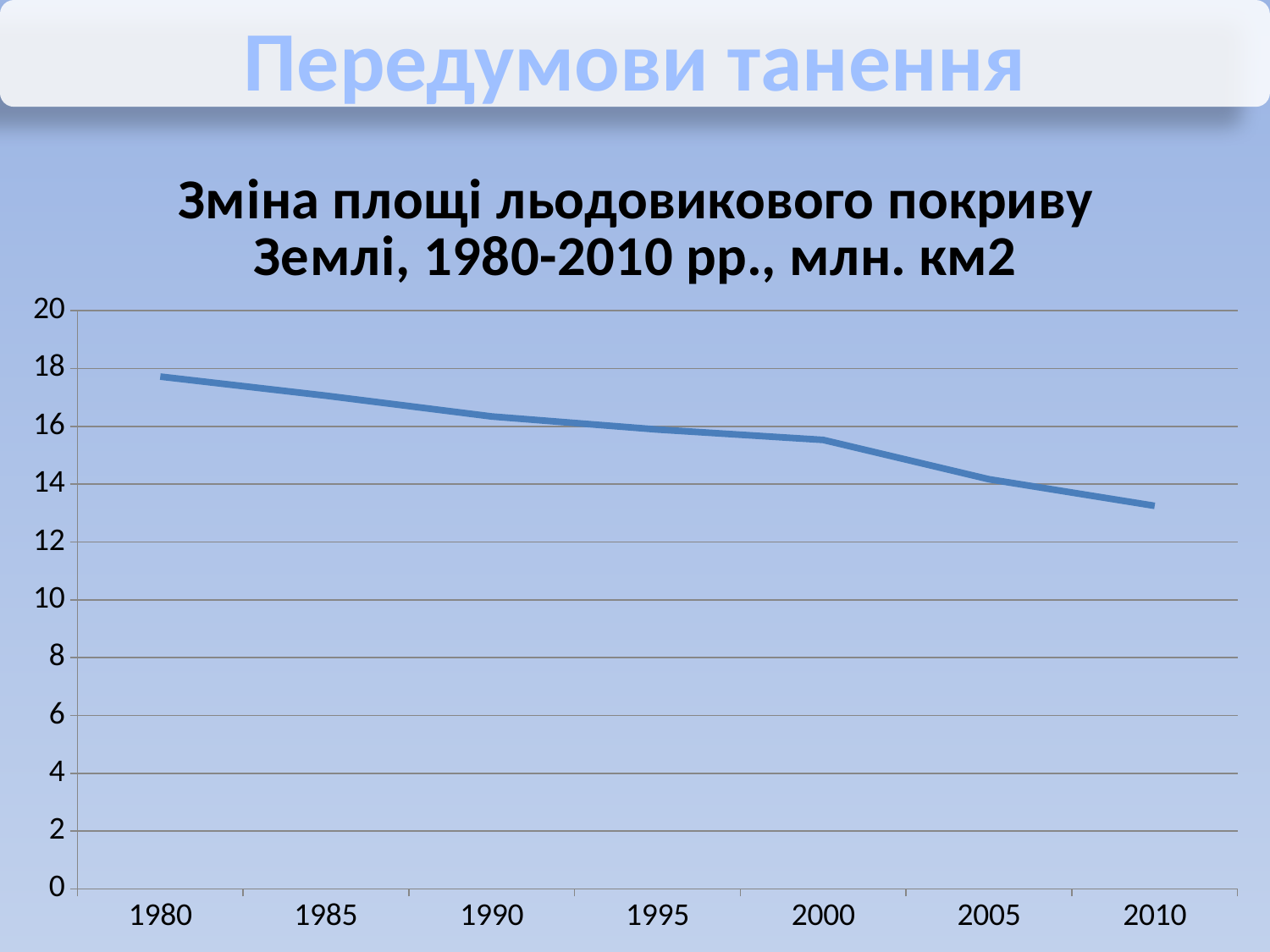
Is the value for 2010 greater or less than 14? less Which year has the highest value? 1980 What is the title of the chart? Зміна площі льодовикового покриву Землі, 1980-2010 рр., млн. км2 Is the value for 1980 greater or less than 16? greater Which year has the lowest value? 2010 What is the highest value shown on the vertical axis? 20 Which is larger, the value for 2000 or the value for 2005? 2000 Is the value for 1985 greater or less than 16? greater What kind of chart is shown on the slide? line chart How many data points are plotted on the line? 7 Do the values rise or fall from 1980 to 2010? fall